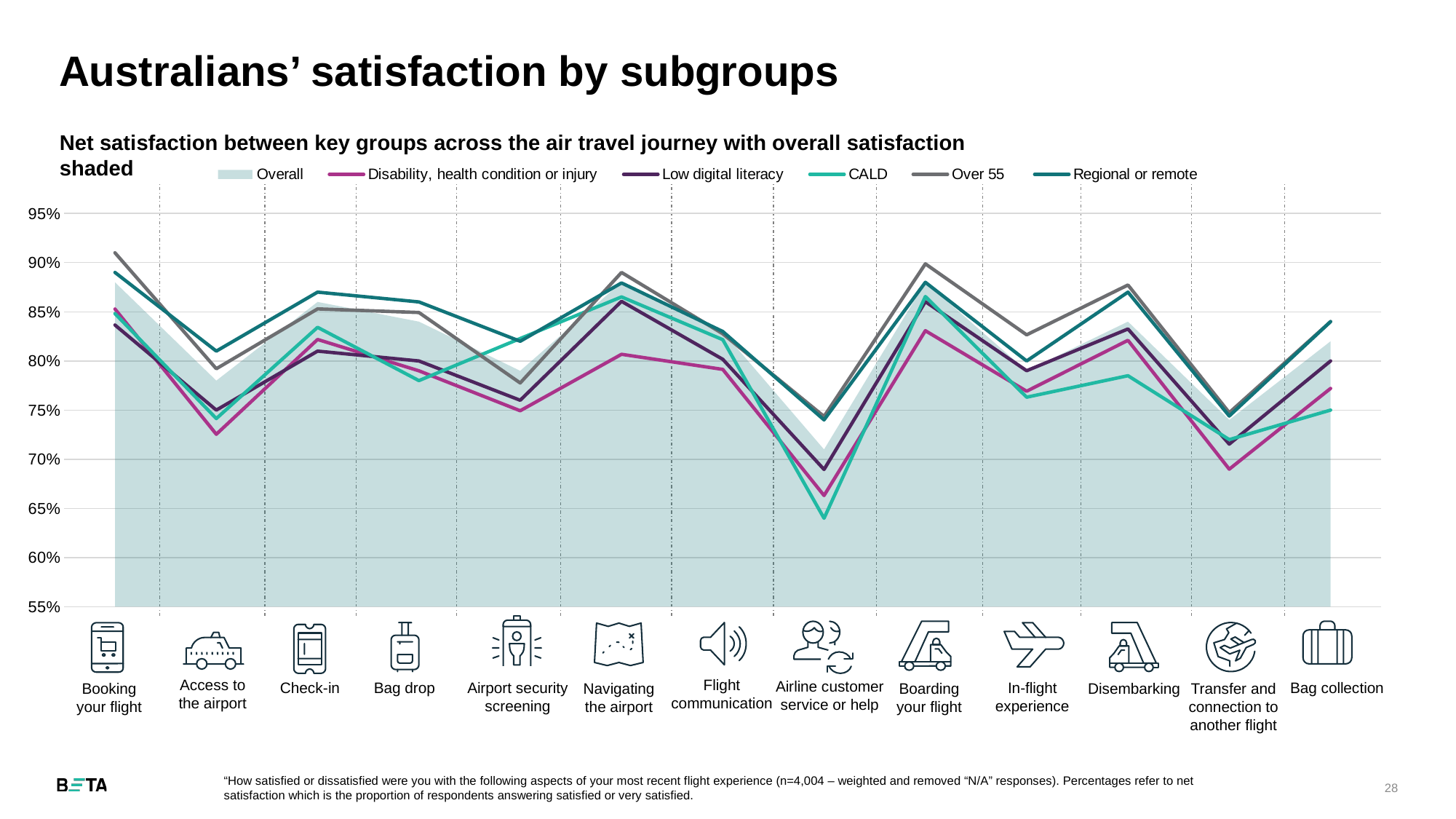
What is the title of the slide? Australians' satisfaction by subgroups How many stages of the air travel journey are shown along the x axis? 13 For the CALD series, which stage of the journey has the lowest net satisfaction? Airline customer service or help Is the Regional or remote value for Bag collection greater or less than 80%? greater At Airline customer service or help, which is higher: Over 55 or CALD? Over 55 Do the lines rise or fall from Airline customer service or help to Boarding your flight? rise Is the CALD value for Airline customer service or help greater or less than 65%? less Is the Disability, health condition or injury value for Transfer and connection to another flight greater or less than 70%? less How many series does the legend list? 6 What kind of chart is shown on the slide? Line chart with a shaded area Which series is shown as a shaded area rather than a line? Overall